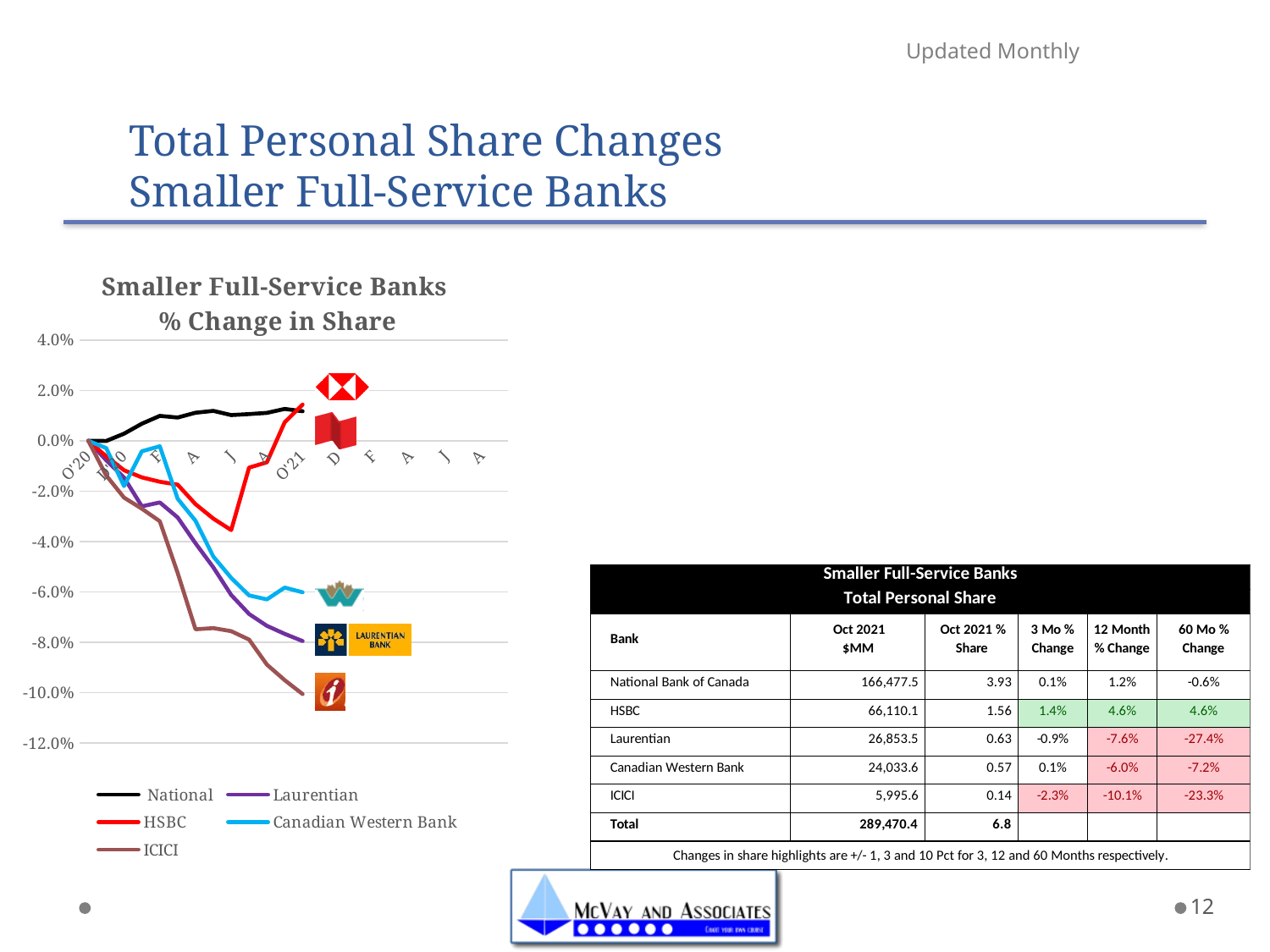
Is the value for Laurentian at O'21 greater or less than -10.0%? greater Does the National line rise or fall from O'20 to O'21? rise Does the ICICI line rise or fall from O'20 to O'21? fall At O'21, which is higher: Laurentian or ICICI? Laurentian Is the value for Canadian Western Bank at O'21 greater or less than -4.0%? less What kind of chart is shown on the slide? line chart Which series has the lowest value at the end of the chart (O'21)? ICICI What is the title of the chart? Smaller Full-Service Banks % Change in Share Is the value for National at O'21 greater or less than 0.0%? greater At O'21, which is higher: Canadian Western Bank or Laurentian? Canadian Western Bank How many series does the chart legend list? 5